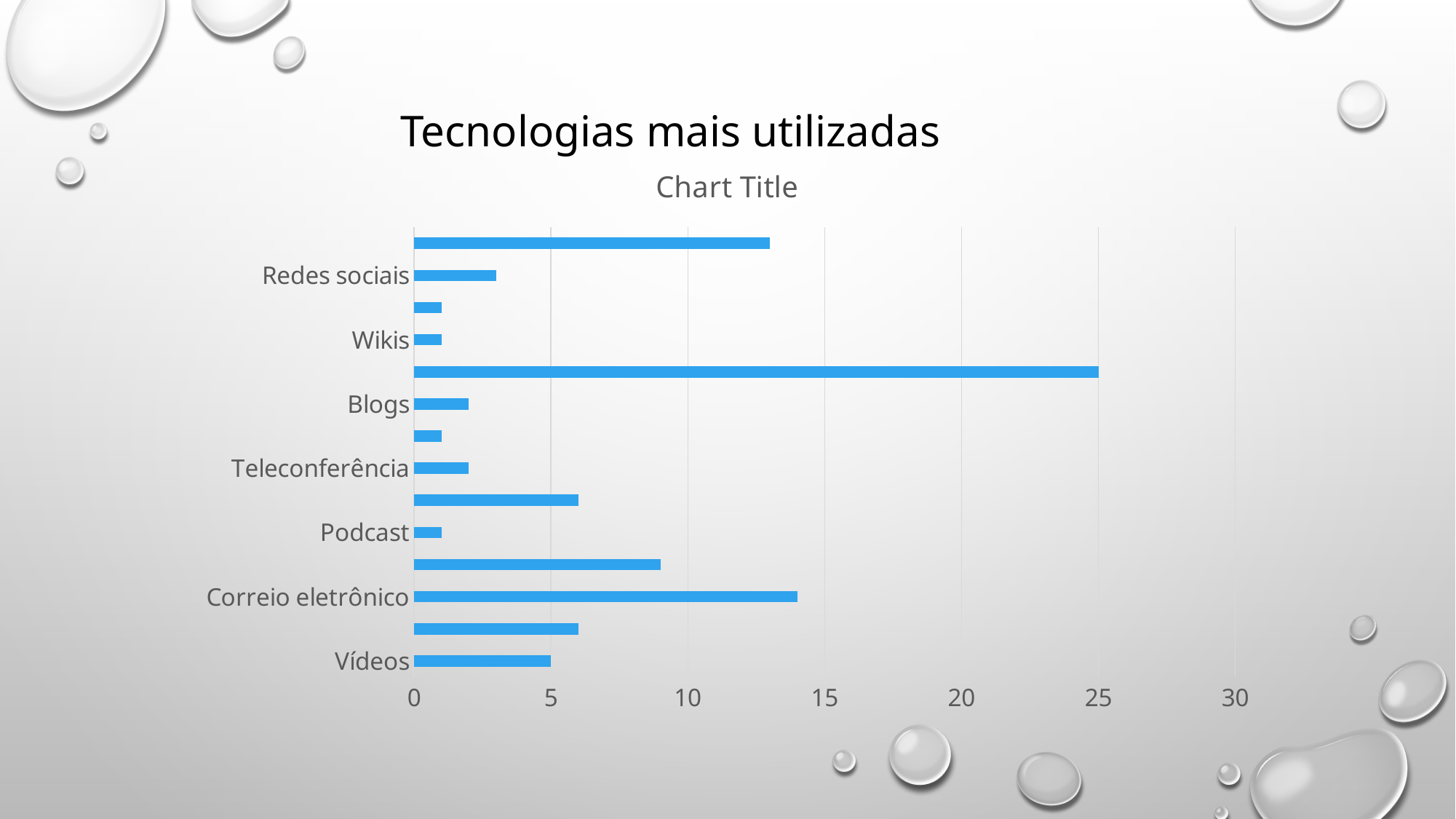
How many category labels are shown on the vertical axis? 7 Which has the larger value, Correio eletrônico or Vídeos? Correio eletrônico Is the value for Correio eletrônico greater or less than 10? greater What is the title printed above the chart? Chart Title Is the value for Correio eletrônico greater or less than 15? less What is the value for Vídeos? 5 What kind of chart is shown on the slide? bar chart Which has the larger value, Redes sociais or Wikis? Redes sociais Is the value for Wikis greater or less than 5? less What is the highest value shown on the horizontal axis? 30 Among the labelled categories, which has the highest value? Correio eletrônico